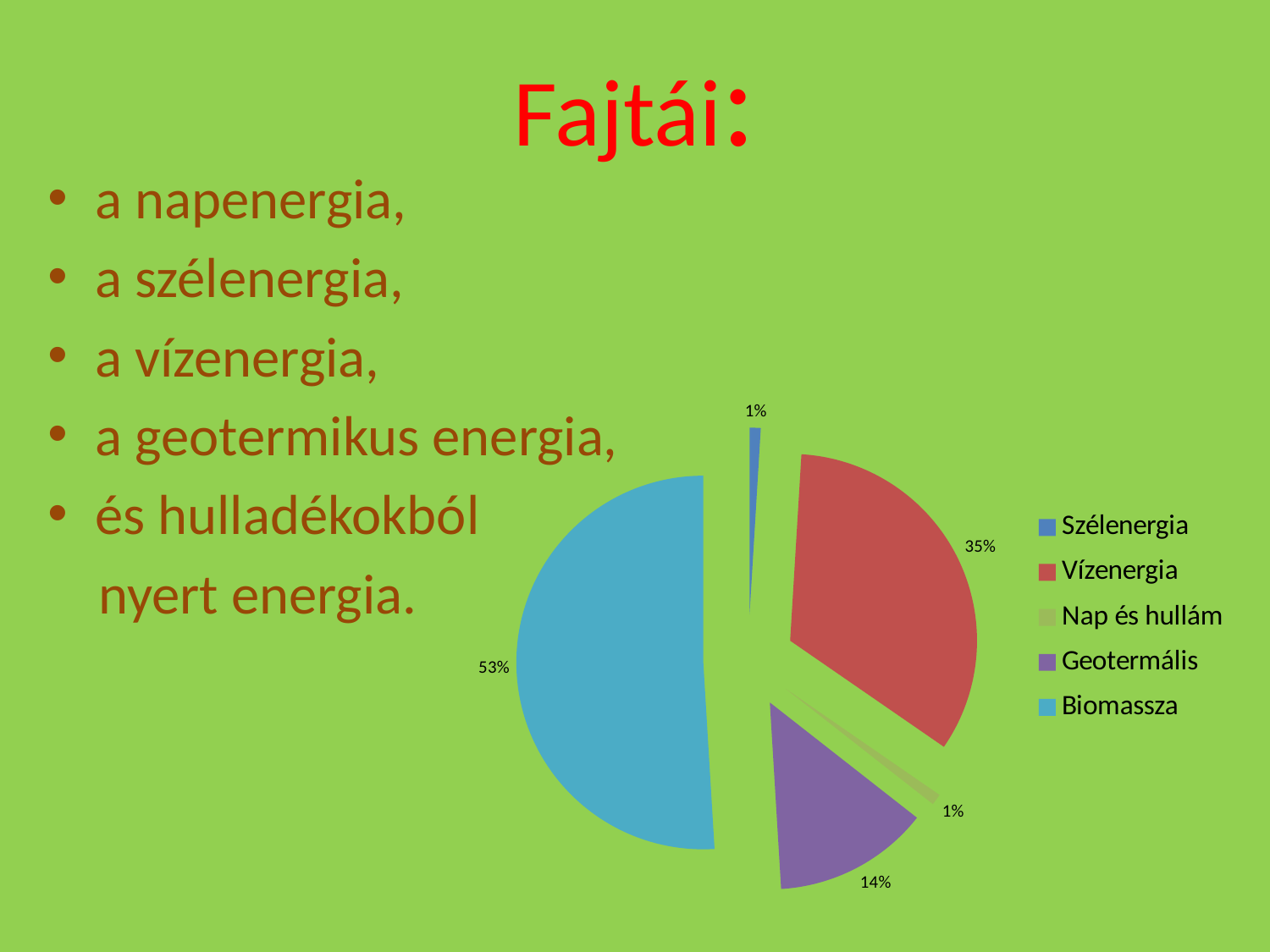
Which legend entry is shown in purple in the pie chart? Geotermális Which legend entry is shown in blue in the pie chart? Szélenergia What share of the pie does Geotermális have? 14% What share of the pie does Szélenergia have? 1% Which is larger, the share for Vízenergia or the share for Geotermális? Vízenergia Which category has the largest slice of the pie? Biomassza What share of the pie does Vízenergia have? 35% What is the difference between the shares of Vízenergia and Geotermális? 21% How many categories does the legend of the pie chart list? 5 What kind of chart is shown on the slide? pie chart What is the difference between the shares of Biomassza and Vízenergia? 18%